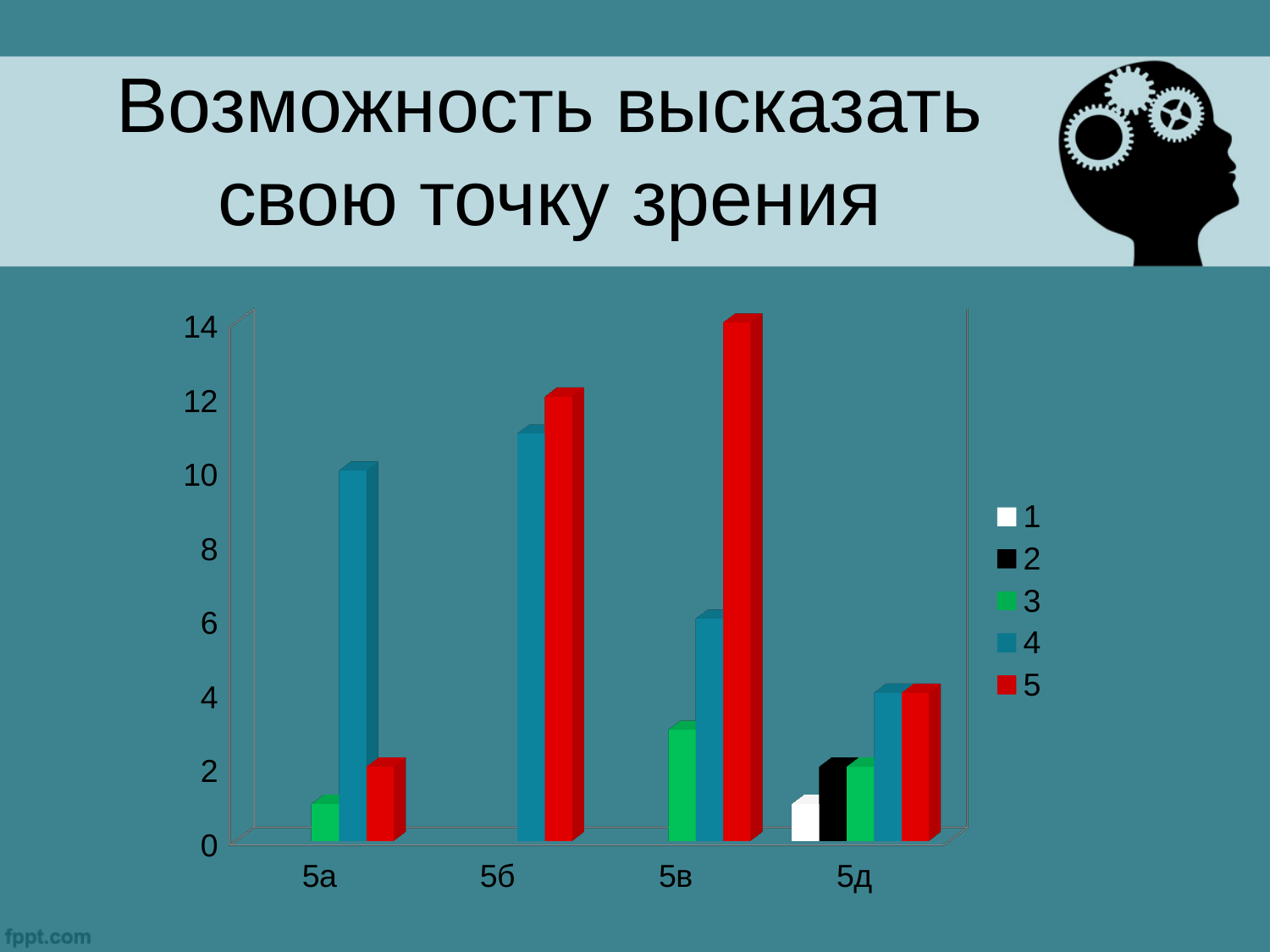
Is the value of series 3 for category 5в greater or less than 4? less What kind of chart is shown on the slide? bar chart How many categories are shown on the x axis of the chart? 4 Is the value of series 4 for category 5б greater or less than 10? greater What is the title of the slide containing the chart? Возможность высказать свою точку зрения How many series does the legend list? 5 Which category has the lowest bar for series 5? 5а What is the value of series 4 for category 5а? 10 Which category has the highest bar for series 5? 5в What is the value of series 5 for category 5в? 14 What is the value of series 5 for category 5б? 12 For category 5а, which is larger: series 4 or series 5? series 4